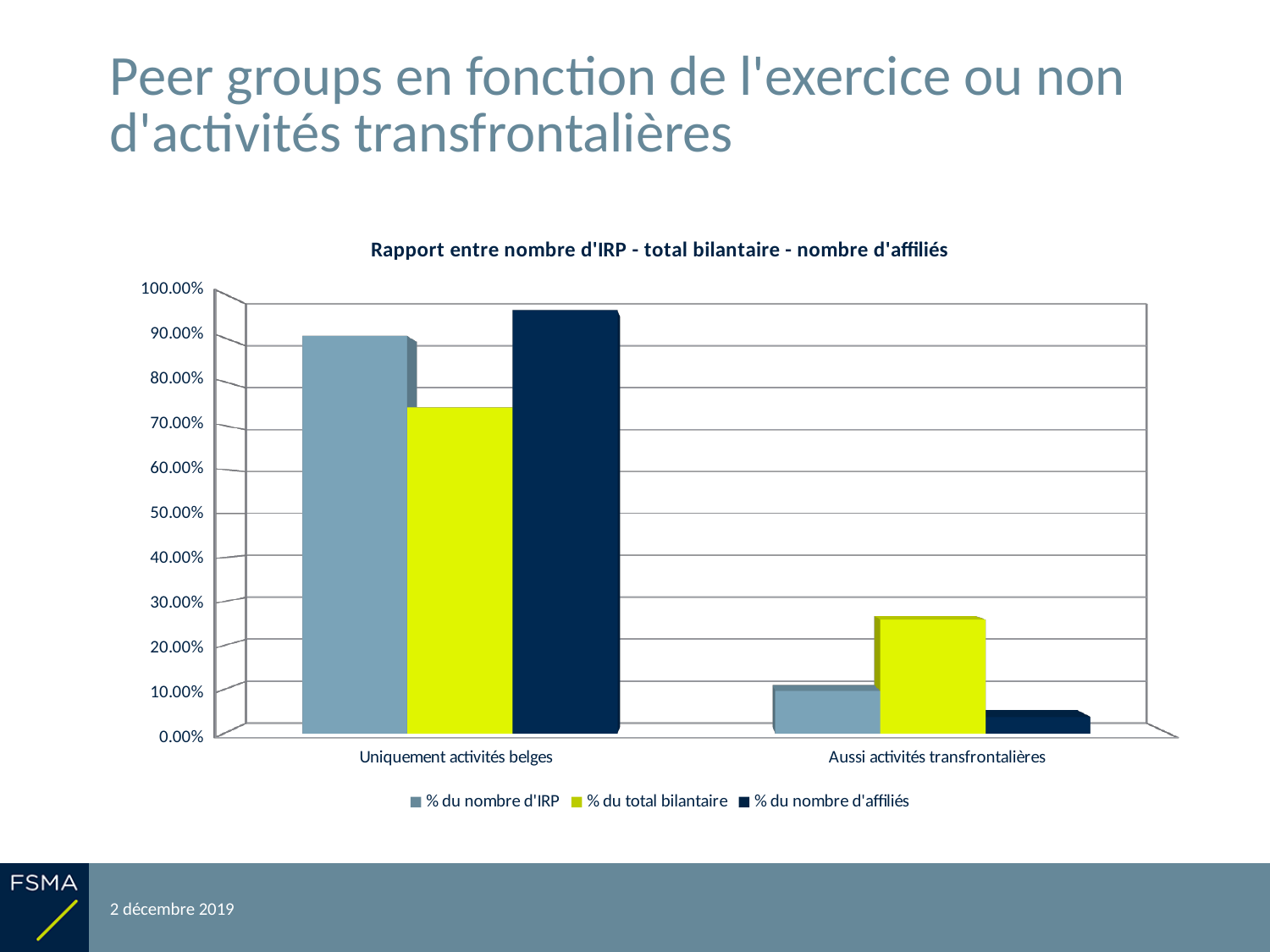
What is the title of the chart? Rapport entre nombre d'IRP - total bilantaire - nombre d'affiliés For % du nombre d'IRP, which category has the larger value: Uniquement activités belges or Aussi activités transfrontalières? Uniquement activités belges How many categories are shown on the x axis? 2 What kind of chart is shown on the slide? bar chart Is the value for % du total bilantaire in Aussi activités transfrontalières greater or less than 20.00%? greater Is the value for % du nombre d'IRP in Aussi activités transfrontalières greater or less than 20.00%? less How many series does the legend list? 3 Which series has the lowest value for Aussi activités transfrontalières? % du nombre d'affiliés Which series has the highest value for Uniquement activités belges? % du nombre d'affiliés Is the value for % du nombre d'affiliés in Uniquement activités belges greater or less than 90.00%? greater Which series is shown in yellow in the legend? % du total bilantaire